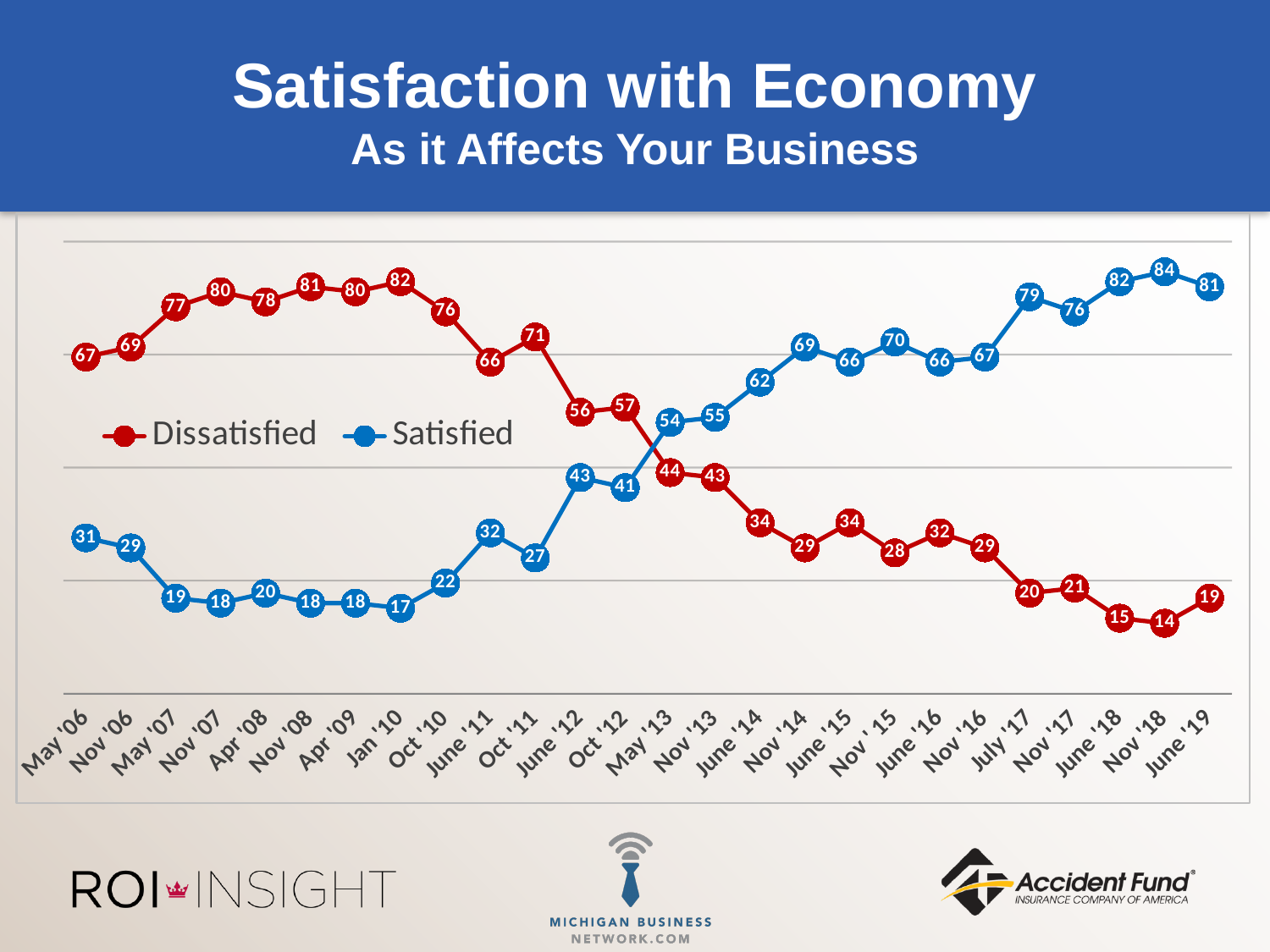
At which date does the Dissatisfied series reach its lowest value? Nov '18 What type of chart is shown on the slide? line chart At which date does the Satisfied series reach its highest value? Nov '18 What is the difference between the Satisfied and Dissatisfied values at June '19? 62 What is the Satisfied value for June '19? 81 Does the Satisfied series generally rise or fall from May '13 to June '19? rise What is the Satisfied value for May '13? 54 What is the Dissatisfied value for Jan '10? 82 Which series has the larger value at Oct '11, Dissatisfied or Satisfied? Dissatisfied How many series does the legend list? 2 At which date does the Satisfied series reach its lowest value? Jan '10 How many dates are plotted along the x axis? 26